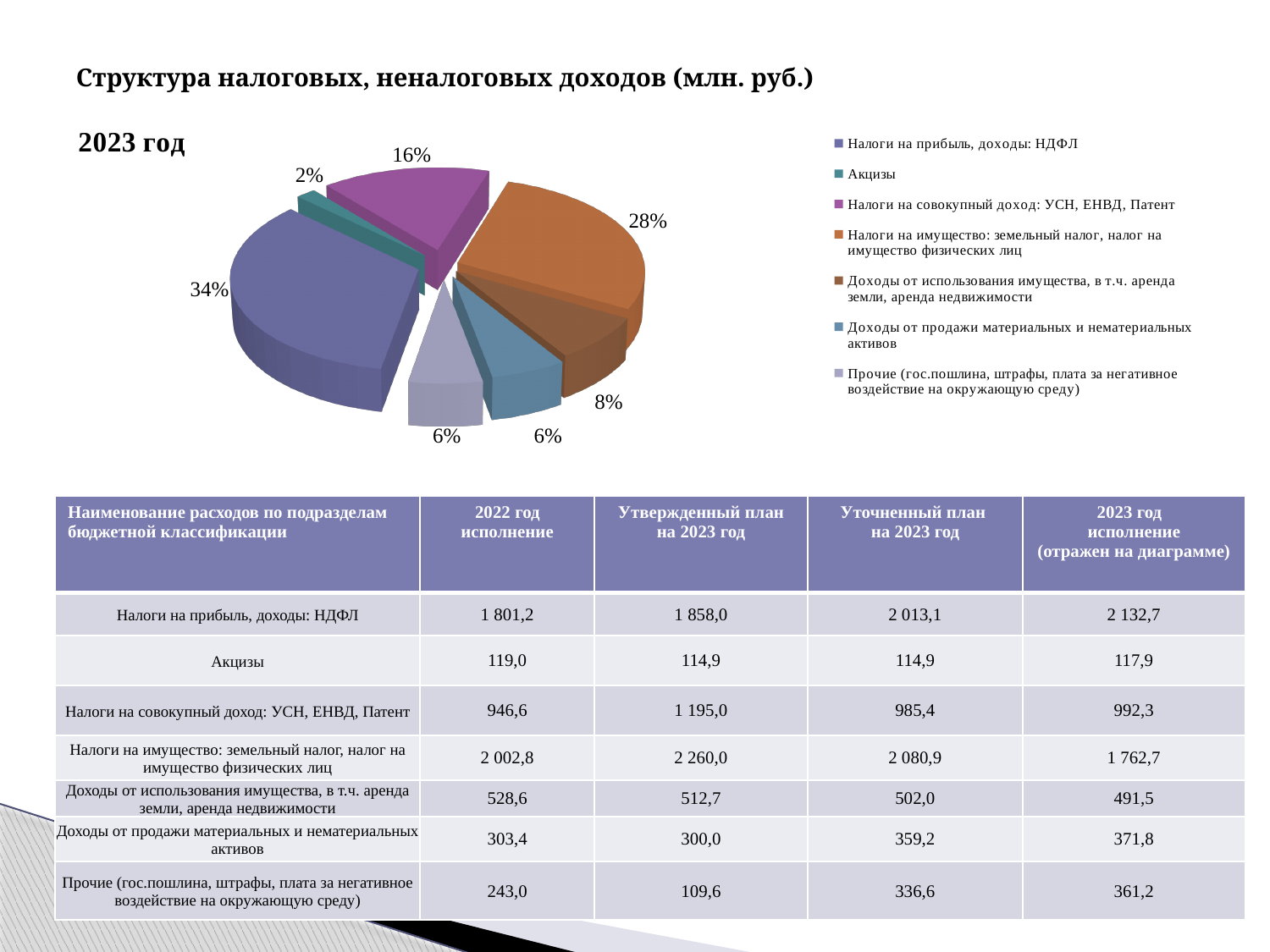
Which category has the largest slice of the pie? Налоги на прибыль, доходы: НДФЛ Which slice is larger: "Налоги на совокупный доход: УСН, ЕНВД, Патент" or "Доходы от использования имущества, в т.ч. аренда земли, аренда недвижимости"? Налоги на совокупный доход: УСН, ЕНВД, Патент How many slices does the pie chart have? 7 What share of the pie does "Доходы от использования имущества, в т.ч. аренда земли, аренда недвижимости" have? 8% Which category has the smallest slice of the pie? Акцизы How many entries does the legend list? 7 What share of the pie does "Акцизы" have? 2% What is the difference in percentage points between the НДФЛ slice and the "Налоги на имущество" slice? 6 What kind of chart is shown on the slide? pie chart What share of the pie does "Налоги на прибыль, доходы: НДФЛ" have? 34%